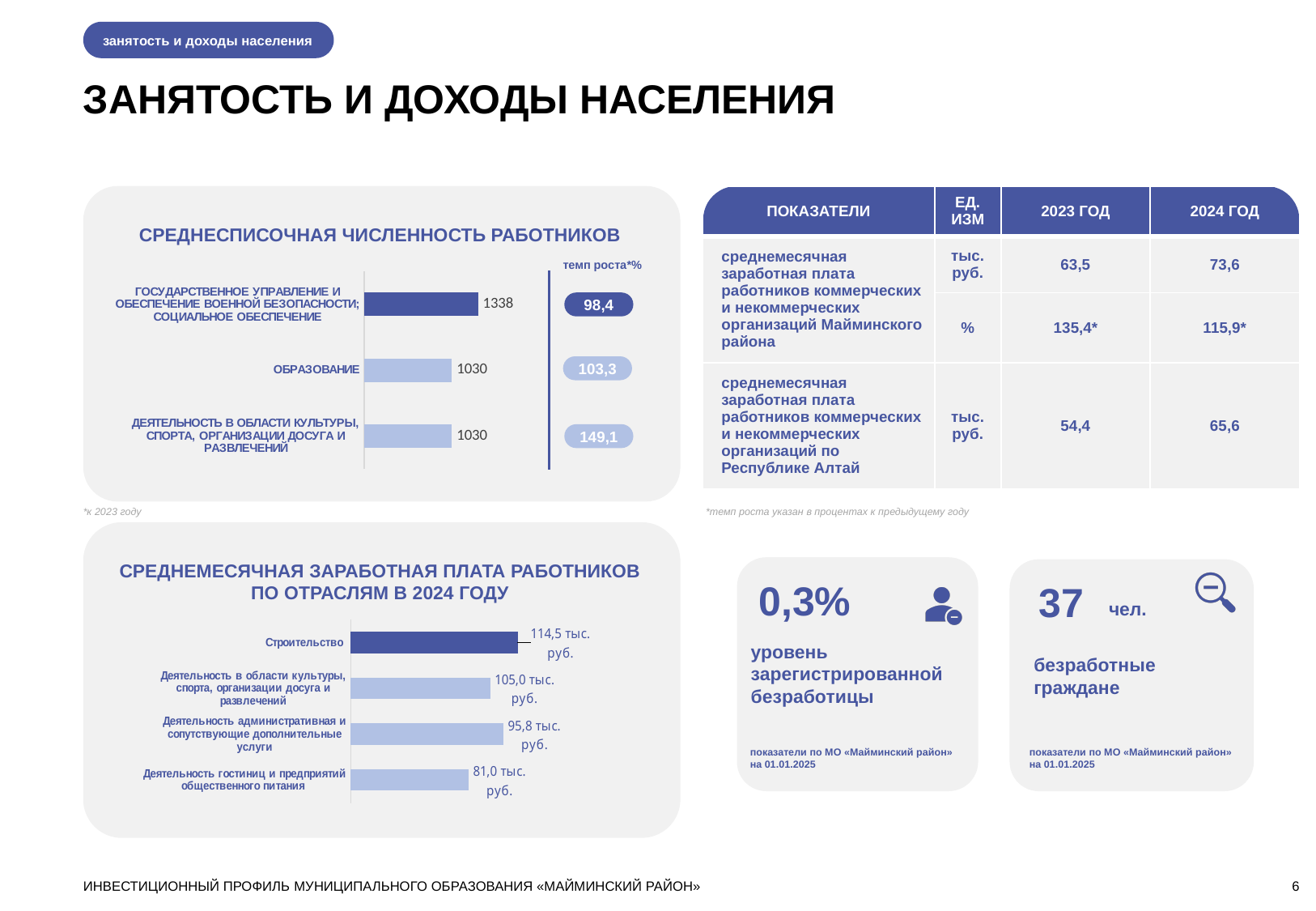
На диаграмме «Среднемесячная заработная плата работников по отраслям в 2024 году» какое значение указано для категории «Деятельность гостиниц и предприятий общественного питания»? 81,0 тыс. руб. На диаграмме «Среднесписочная численность работников» какая категория имеет наибольшее значение? Государственное управление и обеспечение военной безопасности; социальное обеспечение На диаграмме «Среднесписочная численность работников» на сколько значение для государственного управления больше значения для образования? 308 Какого типа диаграмма «Среднесписочная численность работников»? Столбчатая (горизонтальная) диаграмма На диаграмме «Среднесписочная численность работников» какое значение указано для категории «Образование»? 1030 На диаграмме «Среднемесячная заработная плата работников по отраслям в 2024 году» на сколько значение для строительства больше значения для деятельности административной и сопутствующих дополнительных услуг? 18,7 тыс. руб. На диаграмме «Среднемесячная заработная плата работников по отраслям в 2024 году» сколько отраслей показано? 4 На диаграмме «Среднемесячная заработная плата работников по отраслям в 2024 году» какая отрасль имеет наименьшее значение? Деятельность гостиниц и предприятий общественного питания На диаграмме «Среднемесячная заработная плата работников по отраслям в 2024 году» какое значение указано для категории «Строительство»? 114,5 тыс. руб. На диаграмме «Среднесписочная численность работников» какое значение указано для категории «Государственное управление и обеспечение военной безопасности; социальное обеспечение»? 1338 На диаграмме «Среднесписочная численность работников» какой темп роста указан для категории «Деятельность в области культуры, спорта, организации досуга и развлечений»? 149,1 На диаграмме «Среднесписочная численность работников» сколько категорий показано? 3